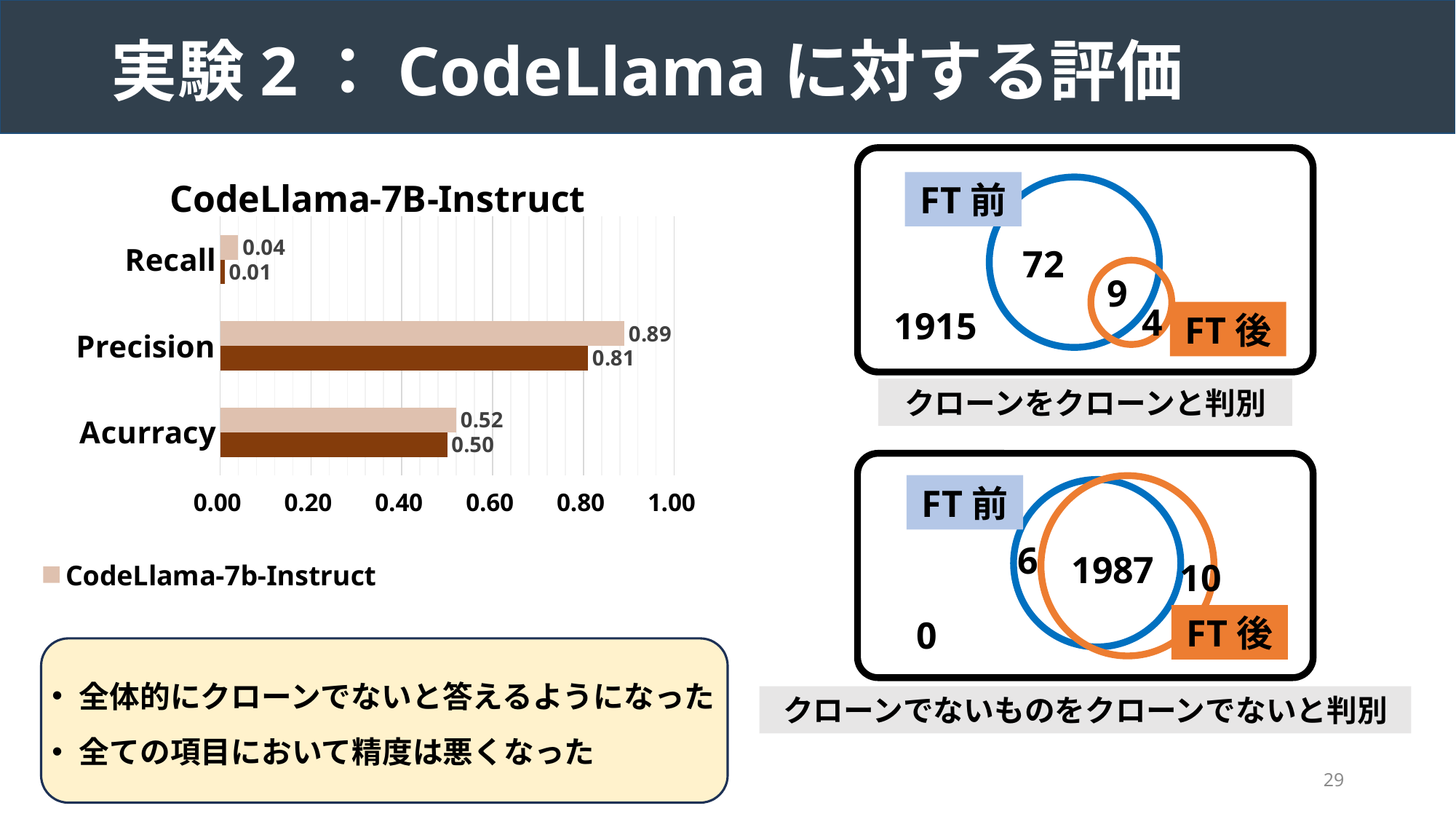
In the CodeLlama-7B-Instruct chart, what is the value of the light tan bar for Acurracy? 0.52 In the CodeLlama-7B-Instruct chart, is the light tan bar for Precision greater or less than 0.80? greater What kind of chart is the CodeLlama-7B-Instruct chart? bar chart In the CodeLlama-7B-Instruct chart, what is the value of the light tan bar for Precision? 0.89 In the CodeLlama-7B-Instruct chart, what is the value of the dark brown bar for Recall? 0.01 In the CodeLlama-7B-Instruct chart, which category has the highest value for the light tan bars? Precision In the CodeLlama-7B-Instruct chart, is the light tan bar or the dark brown bar larger for Acurracy? the light tan bar How many categories are shown on the y axis of the CodeLlama-7B-Instruct chart? 3 In the CodeLlama-7B-Instruct chart, what is the difference between the light tan and dark brown bars for Precision? 0.08 In the CodeLlama-7B-Instruct chart, which category has the lowest value for the dark brown bars? Recall In the CodeLlama-7B-Instruct chart, what is the value of the dark brown bar for Precision? 0.81 In the CodeLlama-7B-Instruct chart, what is the difference between the light tan and dark brown bars for Recall? 0.03